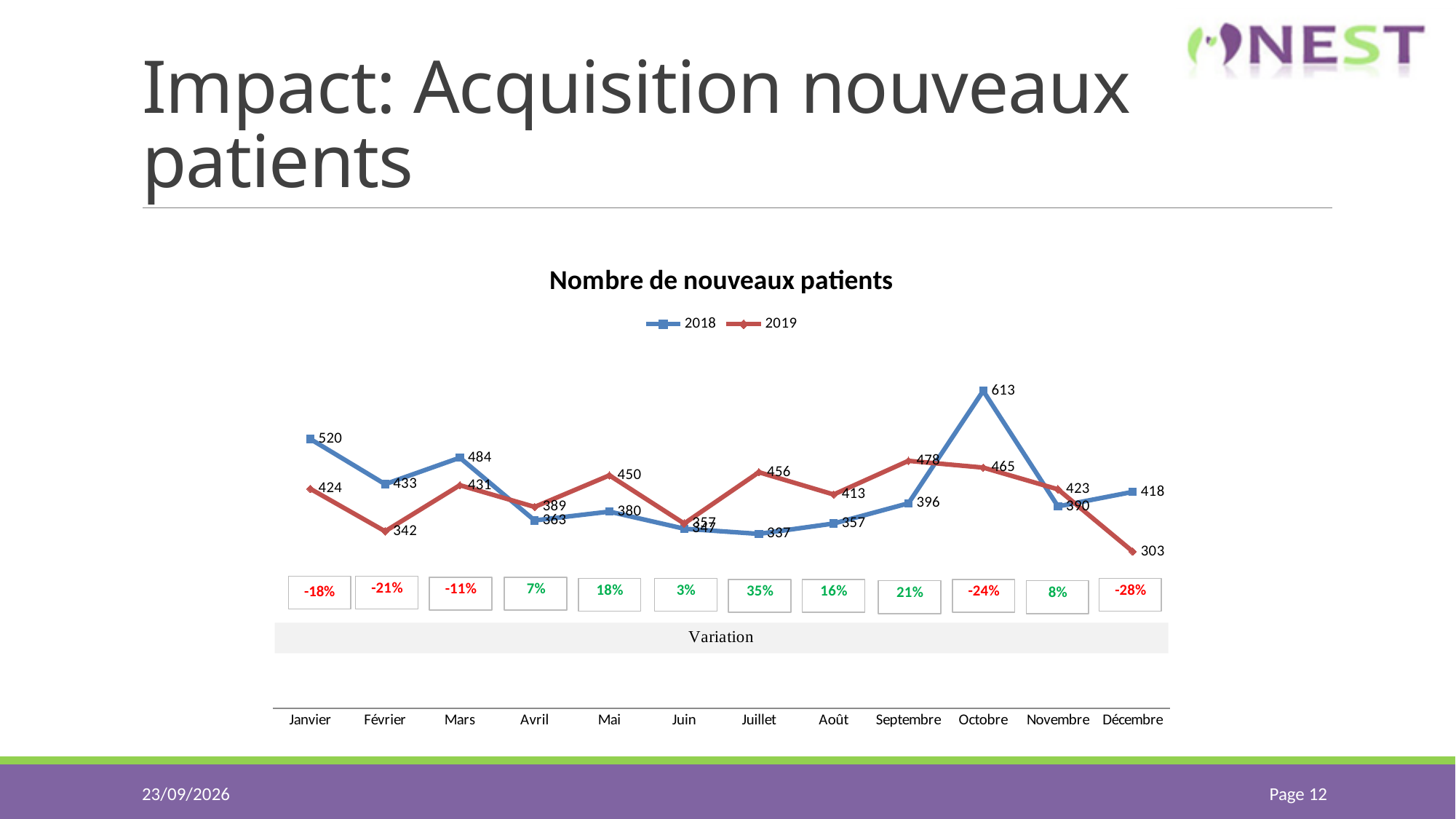
What is the value for 2019 in Décembre? 303 In Mai, which series has the larger value, 2018 or 2019? 2019 In which month is the 2019 series lowest? Décembre What kind of chart is shown on the slide? line chart In which month is the 2018 series highest? Octobre How many months are plotted along the x axis? 12 What is the value for 2018 in Octobre? 613 What is the difference between the 2018 and 2019 values in Octobre? 148 What is the difference between the 2018 and 2019 values in Janvier? 96 What is the value for 2019 in Mai? 450 How many series does the legend list? 2 What is the title of the chart? Nombre de nouveaux patients